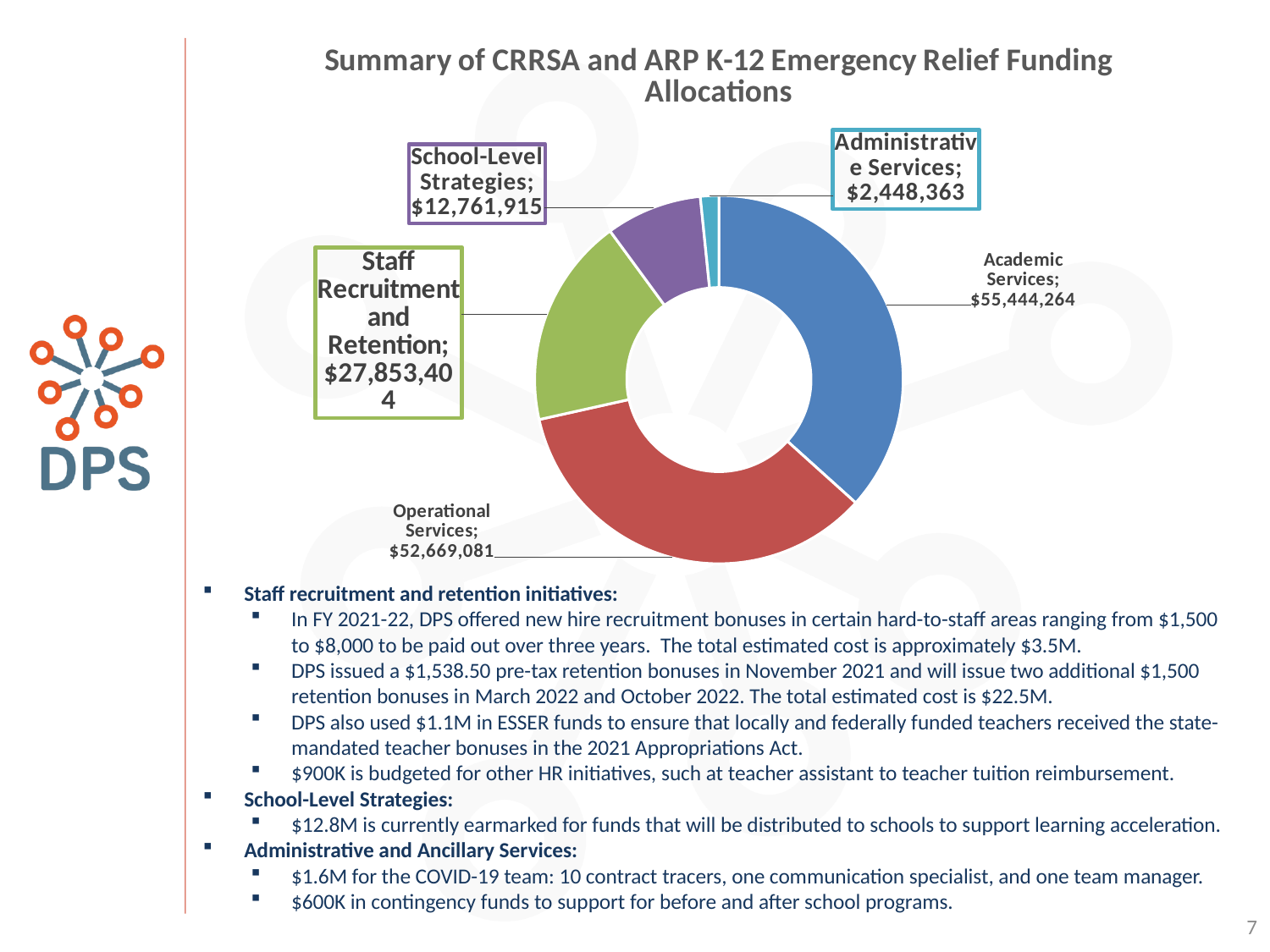
What is the allocation for School-Level Strategies? $12,761,915 Which is larger, the allocation for Staff Recruitment and Retention or for School-Level Strategies? Staff Recruitment and Retention What is the title of the chart? Summary of CRRSA and ARP K-12 Emergency Relief Funding Allocations How many categories are shown in the chart? 5 Which category has the largest allocation? Academic Services What type of chart is shown on the slide? doughnut chart Which category has the smallest allocation? Administrative Services What is the difference between the Academic Services and Operational Services allocations? $2,775,183 What is the allocation for Staff Recruitment and Retention? $27,853,404 What is the allocation for Academic Services? $55,444,264 What is the allocation for Administrative Services? $2,448,363 What is the allocation for Operational Services? $52,669,081